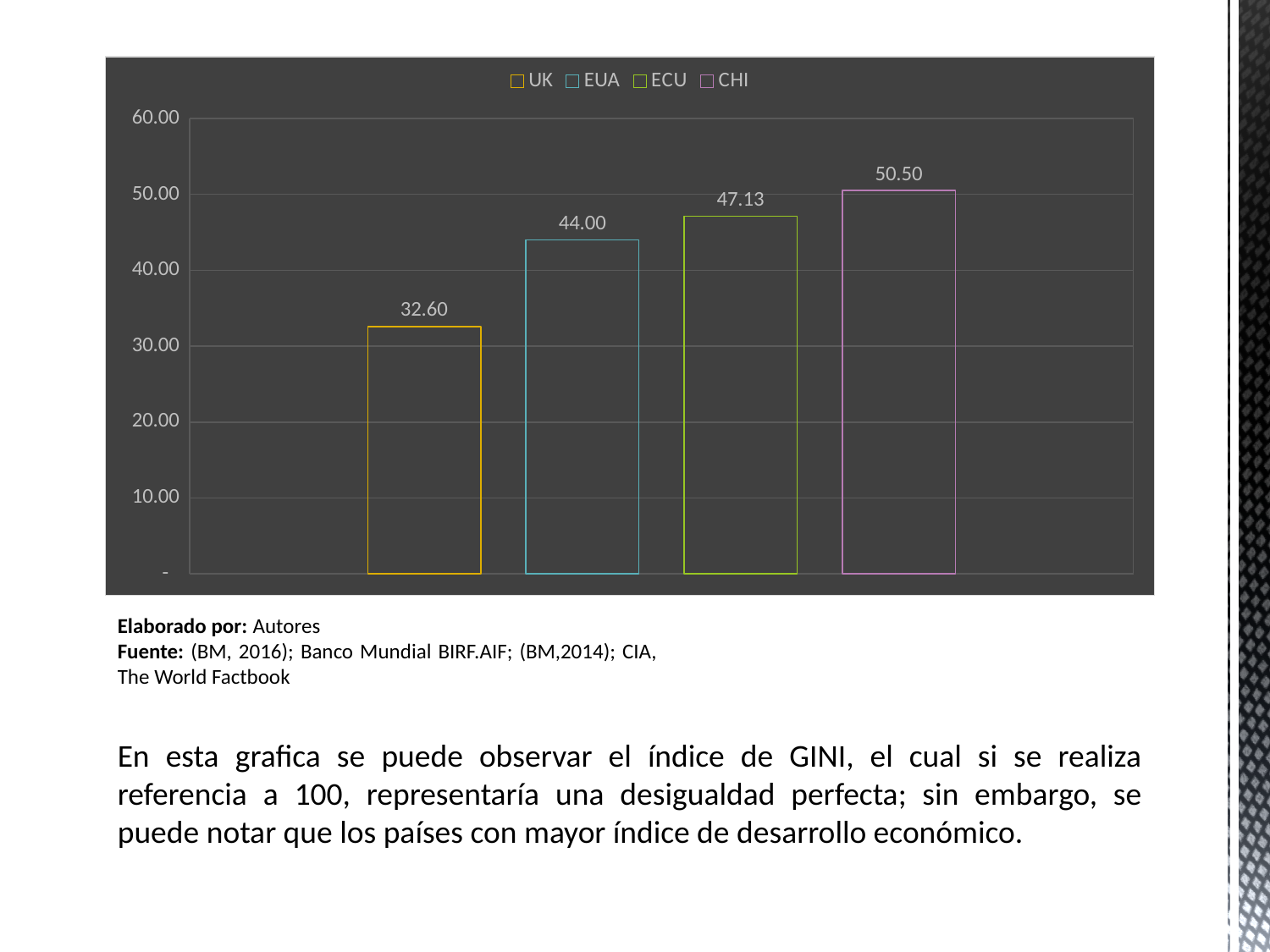
What kind of chart is shown on the slide? bar chart What is the difference between the values for ECU and EUA? 3.13 How many series does the legend list? 4 What is the difference between the values for CHI and UK? 17.90 What is the value for ECU? 47.13 Which series has the lowest value? UK What is the value for UK? 32.60 What is the value for CHI? 50.50 What is the value for EUA? 44.00 Do the bar values rise or fall from left to right? rise Which series has the highest value? CHI Which is larger, the value for EUA or the value for ECU? ECU